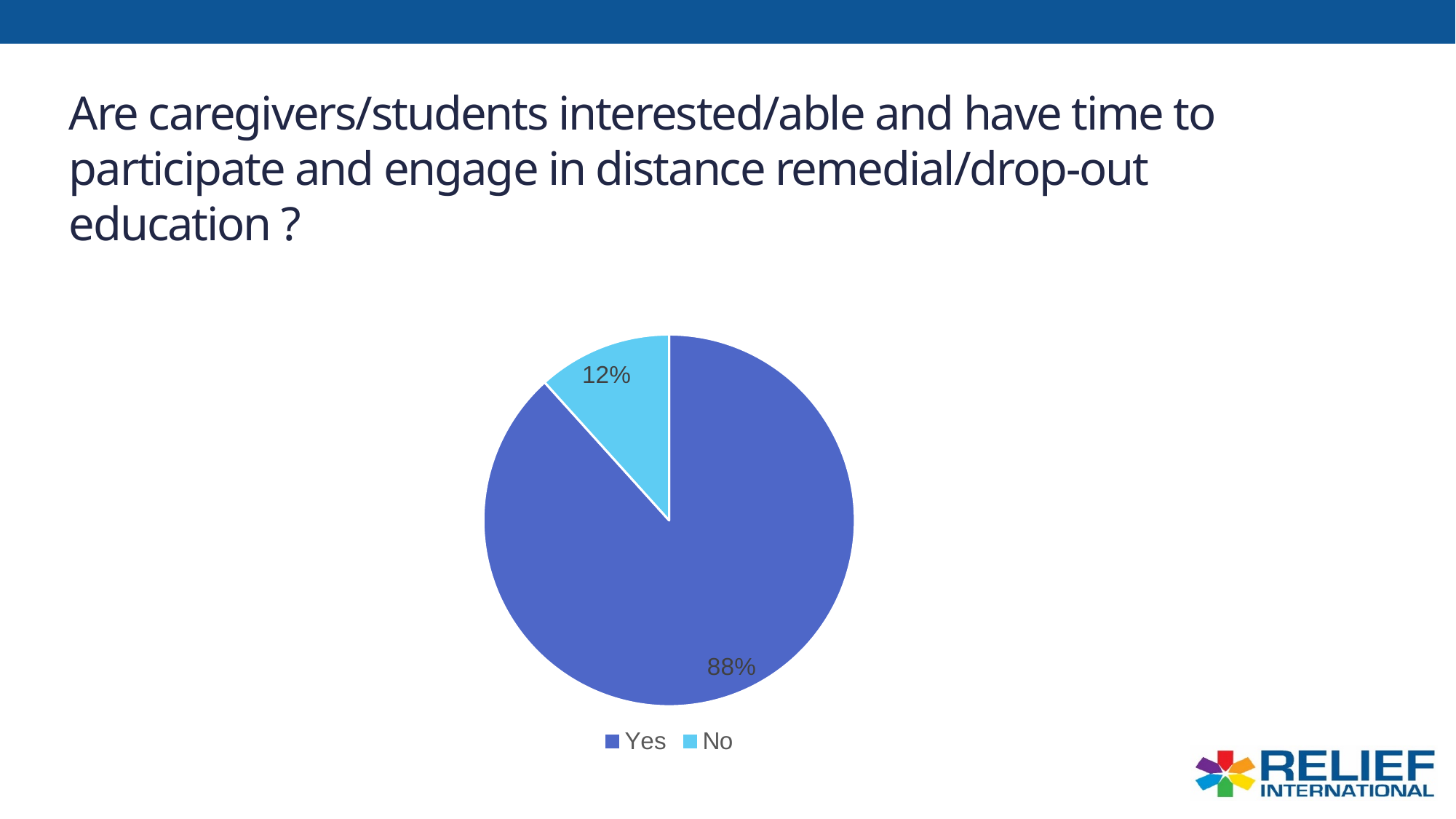
What percentage of the pie is labelled "No"? 12% How many slices does the pie chart have? 2 What colour is the "No" slice in the pie chart? light blue What percentage of the pie is labelled "Yes"? 88% What share of the pie does the "No" slice represent? 12% What are the two legend entries shown below the pie chart? Yes and No Which slice of the pie is the largest? Yes What kind of chart is shown on the slide? pie chart What is the difference in percentage points between the "Yes" and "No" slices? 76 Which slice is larger, "Yes" or "No"? Yes Which slice of the pie is the smallest? No How many entries does the legend list? 2